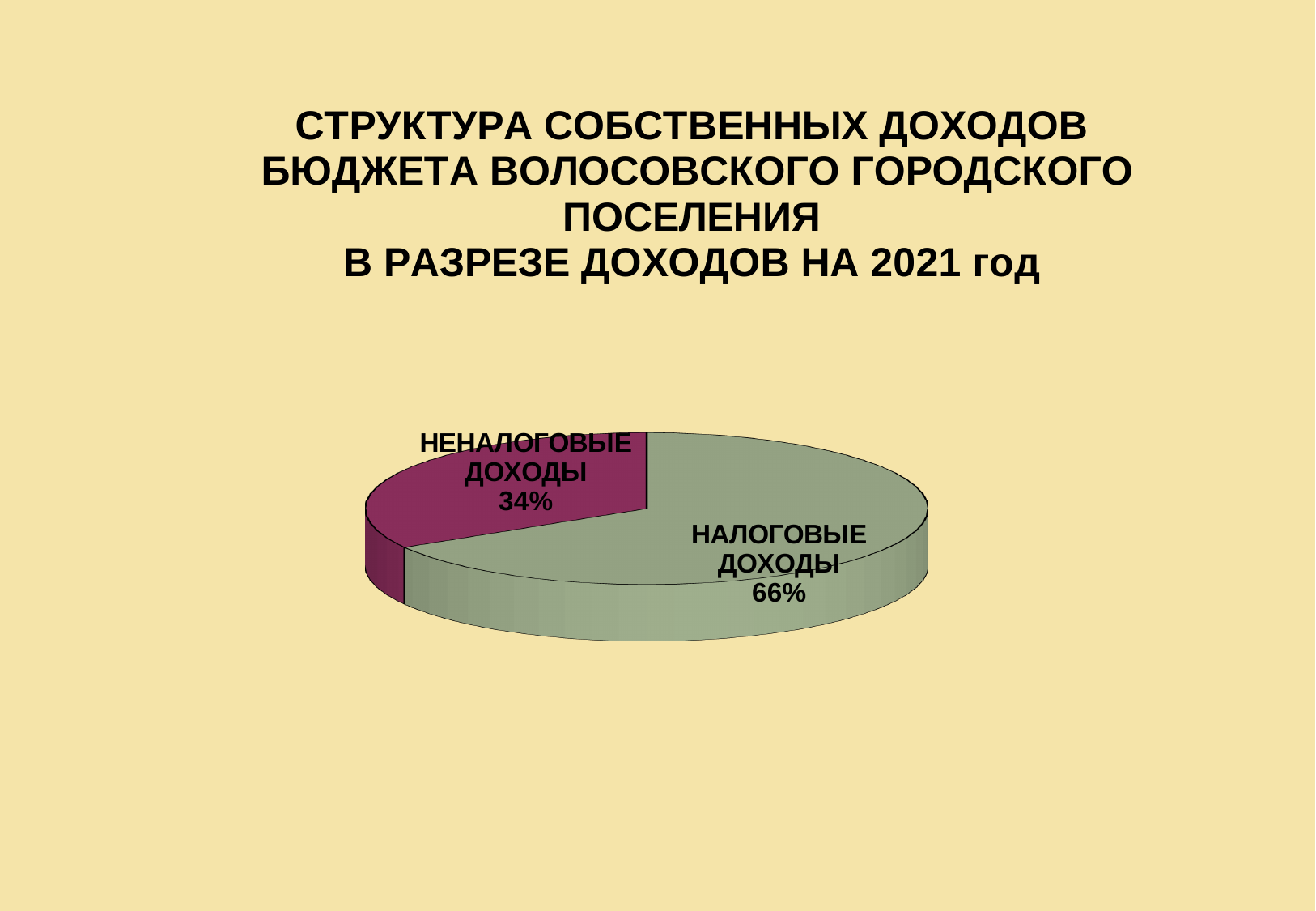
What is the total of the two slices shown in the pie chart? 100% What kind of chart is shown on the slide? Pie chart Is the share for НЕНАЛОГОВЫЕ ДОХОДЫ greater or less than 50%? less What share of the pie does НАЛОГОВЫЕ ДОХОДЫ represent? 66% Which category has the largest slice of the pie? НАЛОГОВЫЕ ДОХОДЫ Which category has the smallest slice of the pie? НЕНАЛОГОВЫЕ ДОХОДЫ Which year does the chart title refer to? 2021 Which is larger, НАЛОГОВЫЕ ДОХОДЫ or НЕНАЛОГОВЫЕ ДОХОДЫ? НАЛОГОВЫЕ ДОХОДЫ What is the difference in percentage points between НАЛОГОВЫЕ ДОХОДЫ and НЕНАЛОГОВЫЕ ДОХОДЫ? 32 What colour is the НЕНАЛОГОВЫЕ ДОХОДЫ slice? Purple (magenta) How many slices does the pie chart have? 2 What share of the pie does НЕНАЛОГОВЫЕ ДОХОДЫ represent? 34%